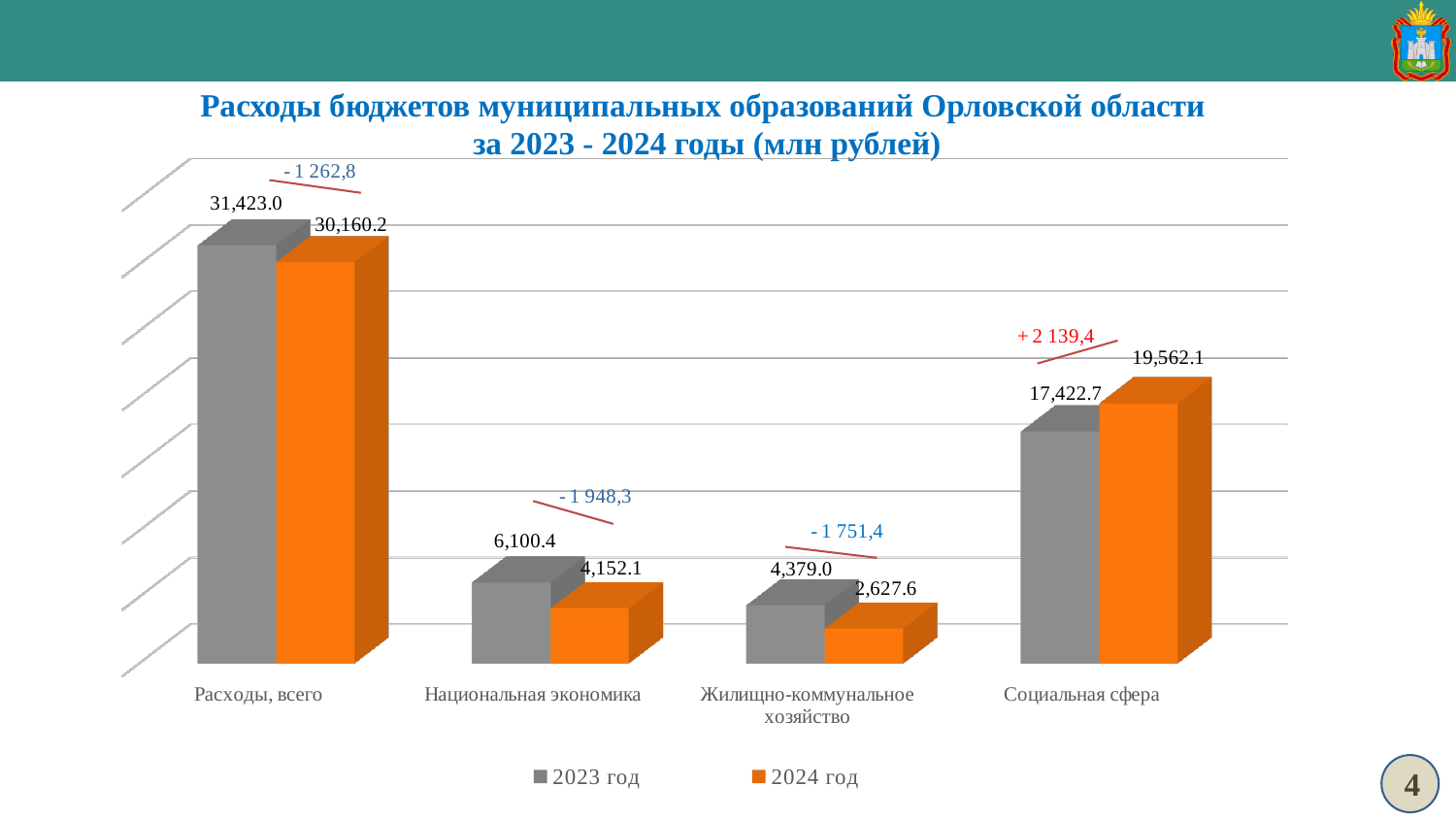
What is the value for Национальная экономика in 2023 год? 6,100.4 What kind of chart is shown on the slide? Bar chart What change is annotated above the Социальная сфера bars? + 2 139,4 Which is larger for Социальная сфера: the 2023 год value or the 2024 год value? 2024 год Which category has the lowest value in the 2024 год series? Жилищно-коммунальное хозяйство How many categories are shown on the x axis? 4 What is the value for Жилищно-коммунальное хозяйство in 2024 год? 2,627.6 How many series does the legend list? 2 Which category has the highest value in the 2023 год series? Расходы, всего What is the value for Расходы, всего in 2023 год? 31,423.0 What is the value for Социальная сфера in 2024 год? 19,562.1 What is the difference between the 2023 год and 2024 год values for Национальная экономика? 1,948.3